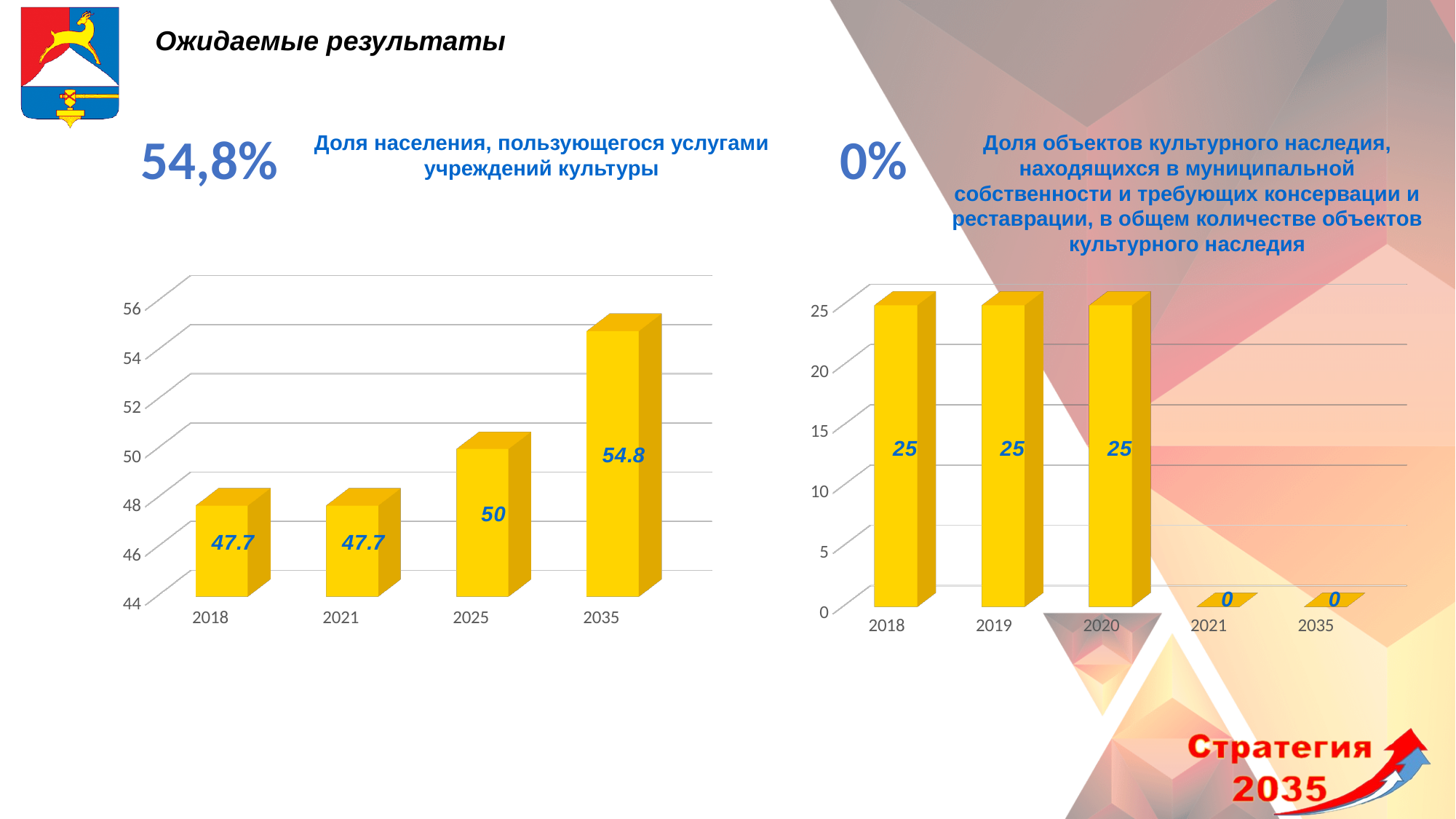
In the left chart, what is the difference between the values for 2035 and 2025? 4.8 In the left chart, what is the value for 2018? 47.7 In the left chart, how many years are shown on the x axis? 4 In the right chart, how many years are shown on the x axis? 5 In the right chart, what is the value for 2035? 0 In the left chart, which year has the highest value? 2035 In the left chart, do the values rise or fall from 2021 to 2035? rise In the left chart (share of population using cultural institution services), what is the value for 2025? 50 What type of chart is the right chart? bar chart In the right chart (share of cultural heritage objects requiring conservation), what is the value for 2019? 25 In the right chart, which is larger, the value for 2020 or the value for 2021? 2020 In the left chart, what is the value for 2035? 54.8